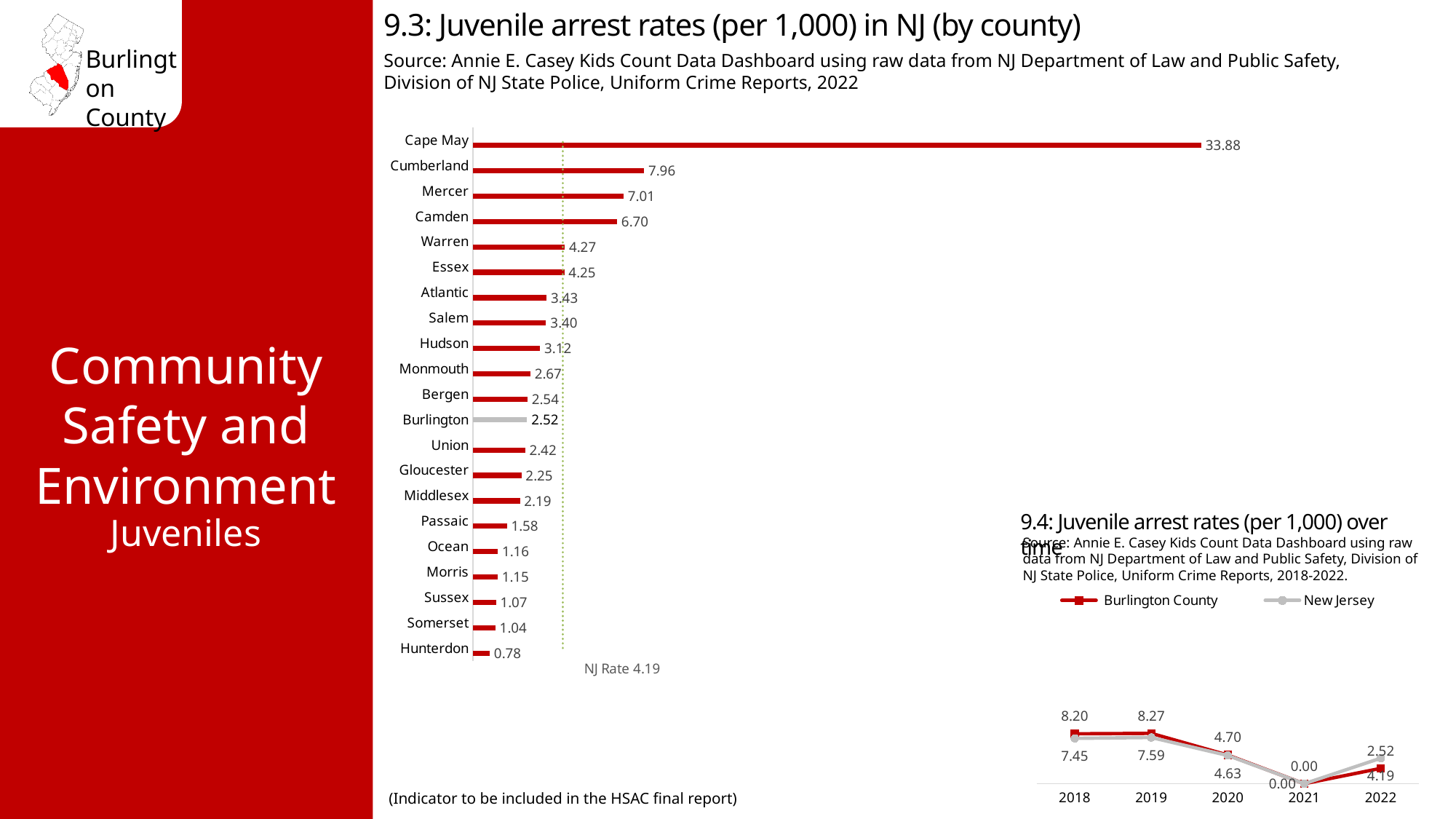
In the chart '9.3: Juvenile arrest rates (per 1,000) in NJ (by county)', what is the value for Burlington? 2.52 In the chart '9.3: Juvenile arrest rates (per 1,000) in NJ (by county)', what is the value for Cape May? 33.88 In the chart '9.4: Juvenile arrest rates (per 1,000) over time', what is the New Jersey value for 2022? 4.19 In the chart '9.4: Juvenile arrest rates (per 1,000) over time', how many series does the legend list? 2 In the chart '9.3: Juvenile arrest rates (per 1,000) in NJ (by county)', which county has the highest rate? Cape May In the chart '9.4: Juvenile arrest rates (per 1,000) over time', what is the Burlington County value for 2019? 8.27 What kind of chart is '9.3: Juvenile arrest rates (per 1,000) in NJ (by county)'? Bar chart In the chart '9.3: Juvenile arrest rates (per 1,000) in NJ (by county)', which county has the lowest rate? Hunterdon In the chart '9.4: Juvenile arrest rates (per 1,000) over time', which is larger in 2018, Burlington County or New Jersey? Burlington County In the chart '9.3: Juvenile arrest rates (per 1,000) in NJ (by county)', how many counties are shown? 21 In the chart '9.3: Juvenile arrest rates (per 1,000) in NJ (by county)', what is the difference between Cumberland and Mercer? 0.95 In the chart '9.3: Juvenile arrest rates (per 1,000) in NJ (by county)', what NJ rate is marked by the dotted reference line? 4.19